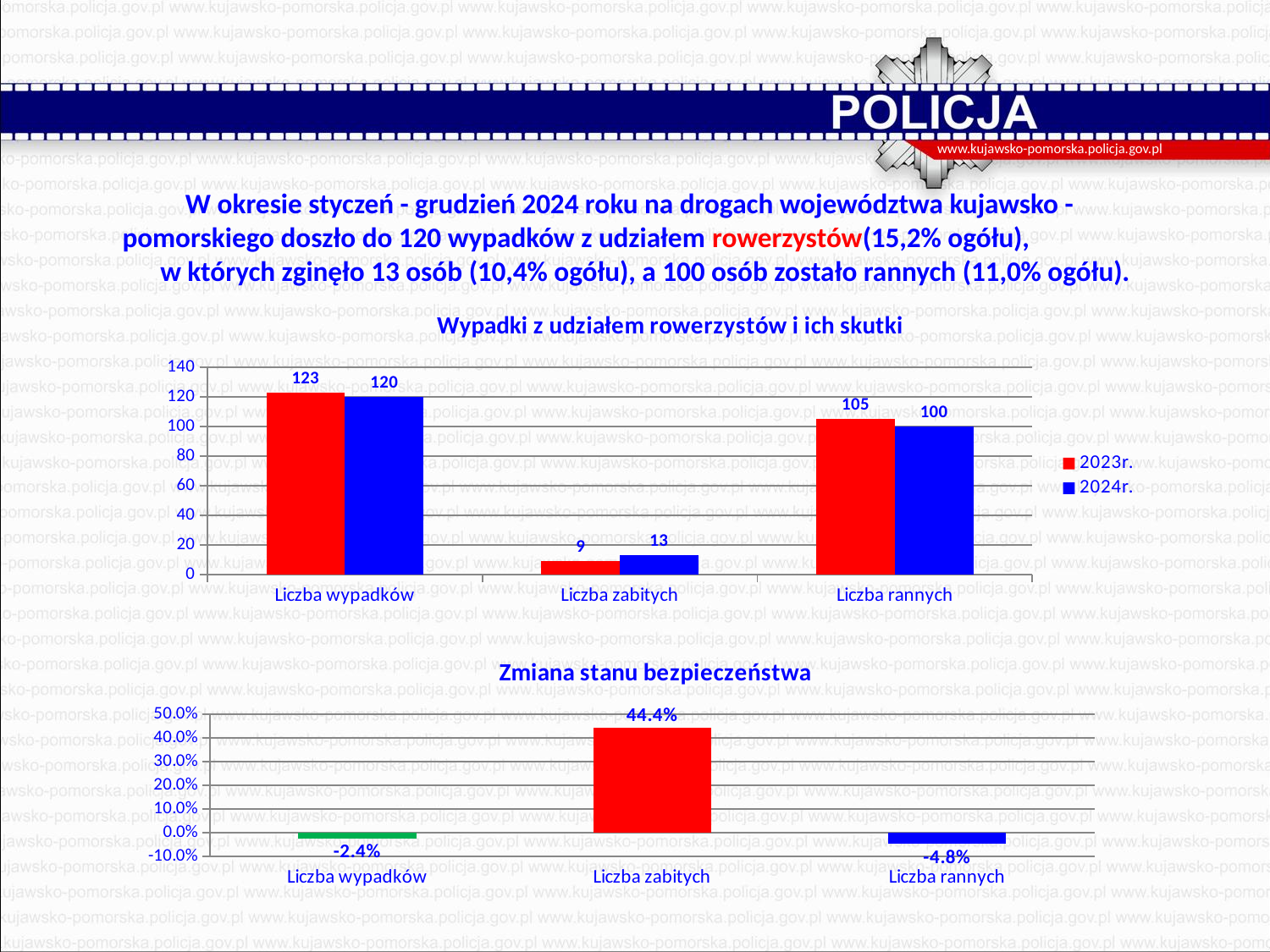
How many categories are shown in the chart 'Zmiana stanu bezpieczeństwa'? 3 In the chart 'Wypadki z udziałem rowerzystów i ich skutki', what is the value for Liczba zabitych in 2024r.? 13 In the chart 'Wypadki z udziałem rowerzystów i ich skutki', which category has the lowest values? Liczba zabitych In the chart 'Wypadki z udziałem rowerzystów i ich skutki', which is larger for Liczba zabitych: 2023r. or 2024r.? 2024r. In the chart 'Wypadki z udziałem rowerzystów i ich skutki', what is the value for Liczba wypadków in 2023r.? 123 In the chart 'Zmiana stanu bezpieczeństwa', what is the value for Liczba rannych? -4.8% How many series does the legend of the chart 'Wypadki z udziałem rowerzystów i ich skutki' list? 2 What kind of chart is 'Zmiana stanu bezpieczeństwa'? bar chart In the chart 'Zmiana stanu bezpieczeństwa', what is the value for Liczba zabitych? 44.4% In the chart 'Wypadki z udziałem rowerzystów i ich skutki', what is the value for Liczba rannych in 2023r.? 105 In the chart 'Wypadki z udziałem rowerzystów i ich skutki', what is the difference between the 2023r. and 2024r. values for Liczba rannych? 5 In the chart 'Zmiana stanu bezpieczeństwa', which category has the lowest value? Liczba rannych